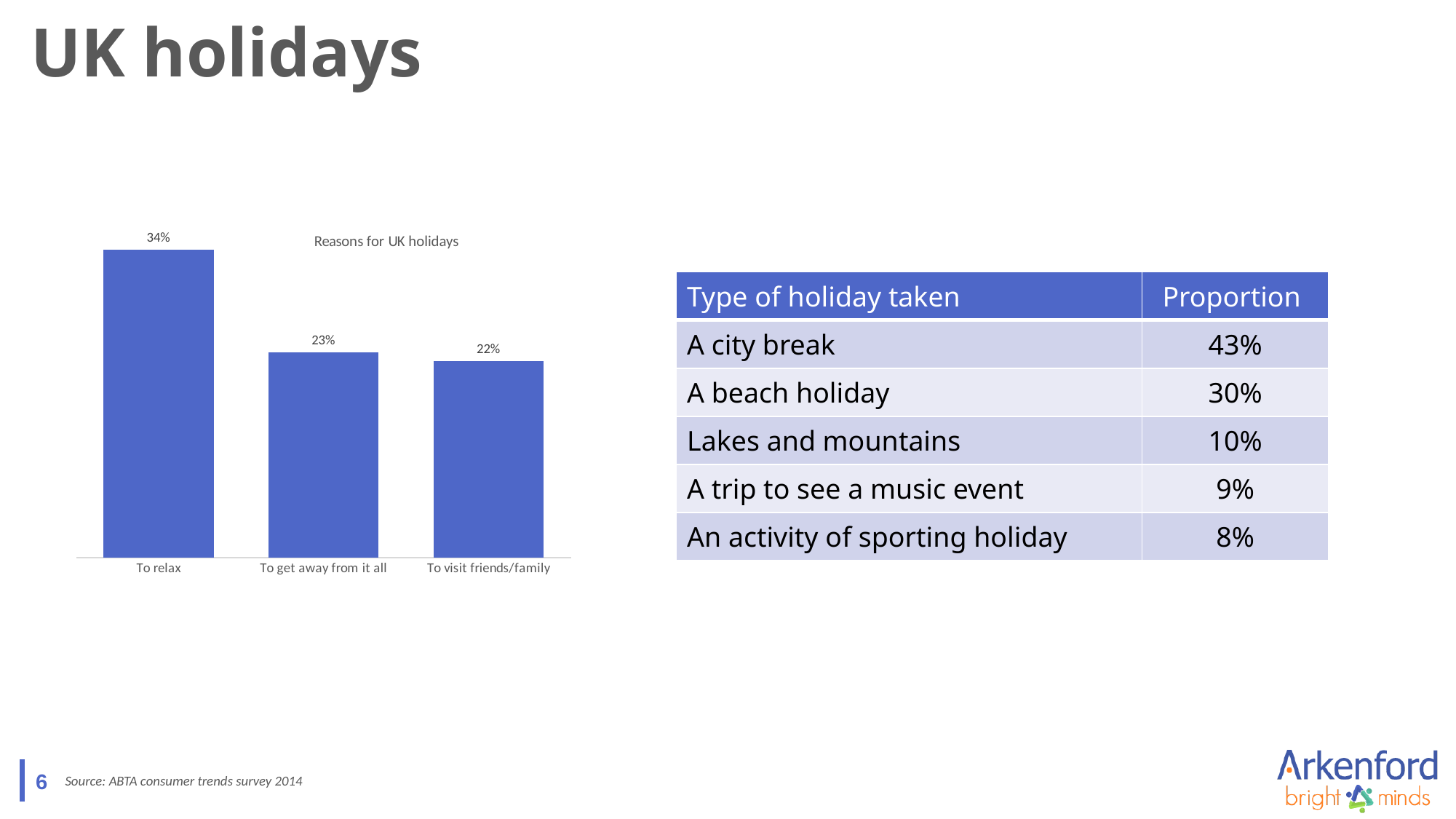
How many categories are shown in the 'Reasons for UK holidays' chart? 3 In the 'Reasons for UK holidays' chart, what is the difference between 'To relax' and 'To get away from it all'? 11% In the 'Reasons for UK holidays' chart, what is the value for 'To relax'? 34% What kind of chart is 'Reasons for UK holidays'? Bar chart In the 'Reasons for UK holidays' chart, what is the value for 'To visit friends/family'? 22% In the 'Reasons for UK holidays' chart, which reason has the lowest value? To visit friends/family What is the title of the chart on the slide? Reasons for UK holidays In the 'Reasons for UK holidays' chart, what is the value for 'To get away from it all'? 23% In the 'Reasons for UK holidays' chart, which reason has the highest value? To relax In the 'Reasons for UK holidays' chart, which is larger: 'To relax' or 'To get away from it all'? To relax In the 'Reasons for UK holidays' chart, what is the difference between 'To relax' and 'To visit friends/family'? 12% In the 'Reasons for UK holidays' chart, do the values rise or fall from left to right? Fall